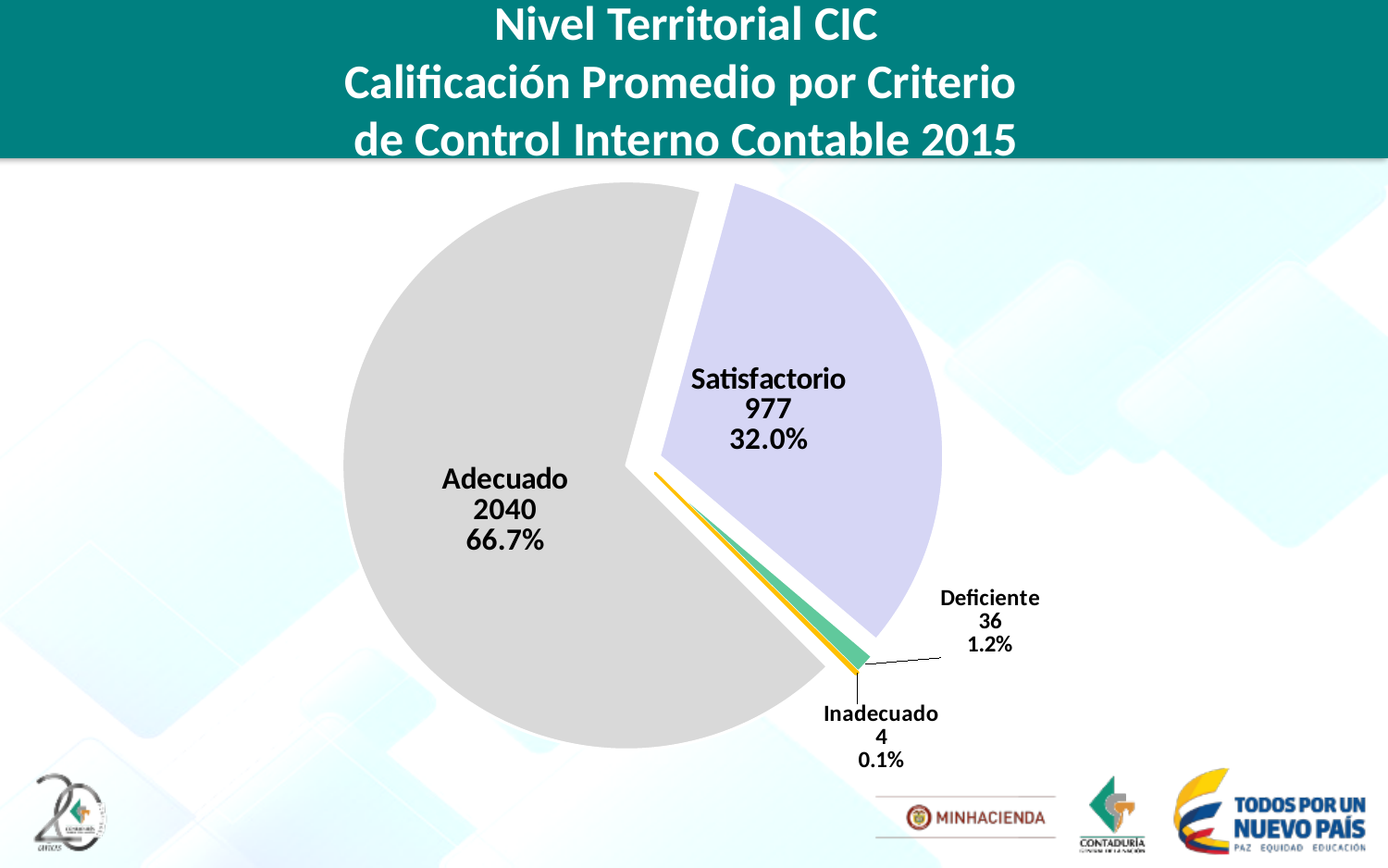
Which category has the smallest slice? Inadecuado Which category has the largest slice? Adecuado What share of the pie does Satisfactorio represent? 32.0% How many slices does the pie chart have? 4 What is the difference between the values for Adecuado and Satisfactorio? 1063 What is the value for Deficiente? 36 What share of the pie does Adecuado represent? 66.7% What is the value for Inadecuado? 4 Which is larger, the value for Deficiente or the value for Inadecuado? Deficiente What kind of chart is shown on the slide? pie chart What is the value for Satisfactorio? 977 What is the value for Adecuado? 2040